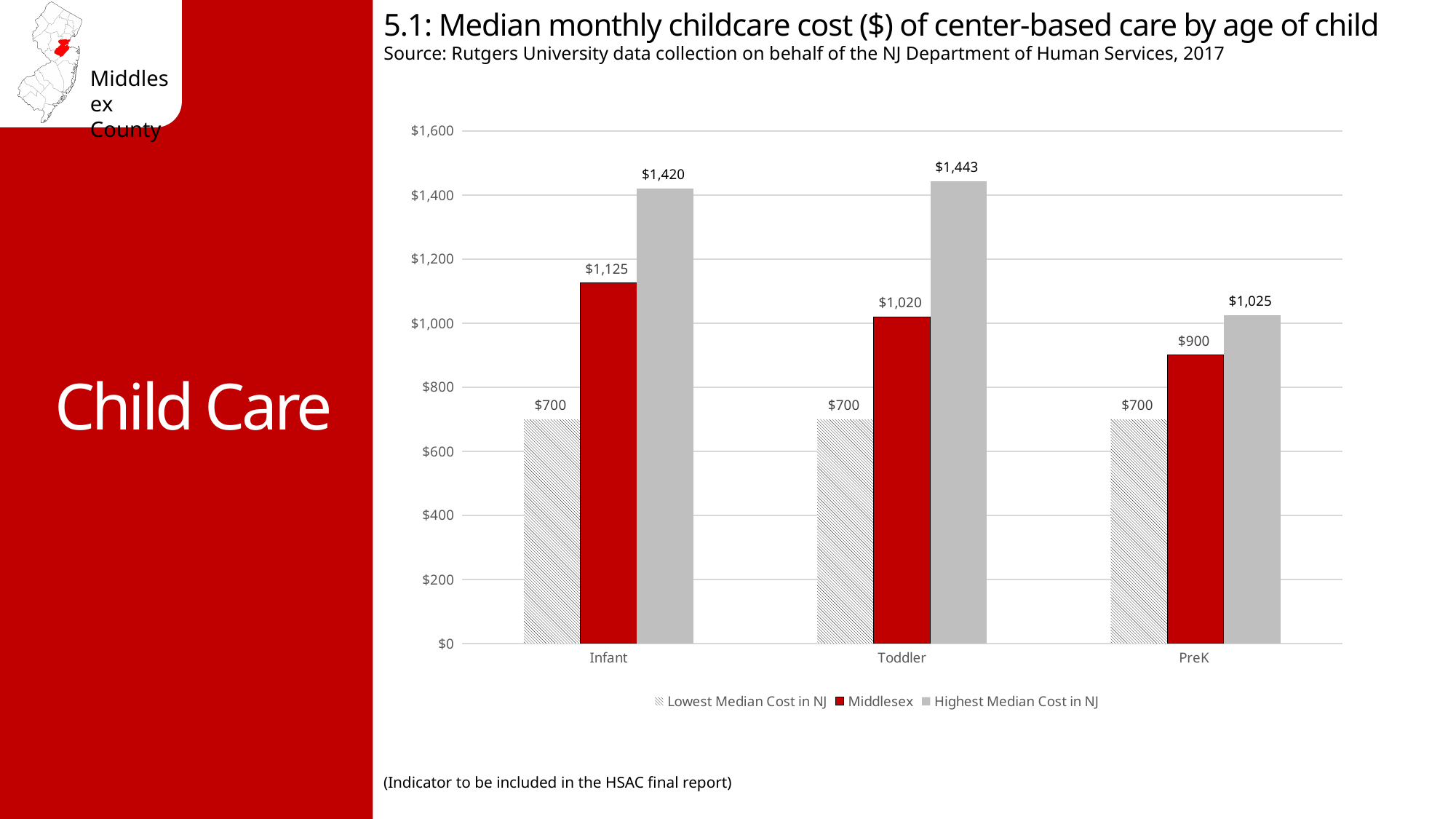
What is the difference between the Highest Median Cost in NJ and the Middlesex cost for Infant care? $295 For which age group is the Highest Median Cost in NJ the lowest? PreK What is the Highest Median Cost in NJ for Toddler care? $1,443 What is the Middlesex median monthly childcare cost for Infant care? $1,125 Is the Middlesex cost for PreK care greater or less than $1,000? less What is the Lowest Median Cost in NJ for PreK care? $700 Which series is shown in red? Middlesex What kind of chart is shown on the slide? bar chart Which is larger for Toddler care: the Middlesex cost or the Highest Median Cost in NJ? Highest Median Cost in NJ How many age groups are shown on the x axis? 3 How many series does the legend list? 3 For which age group is the Middlesex median cost the highest? Infant